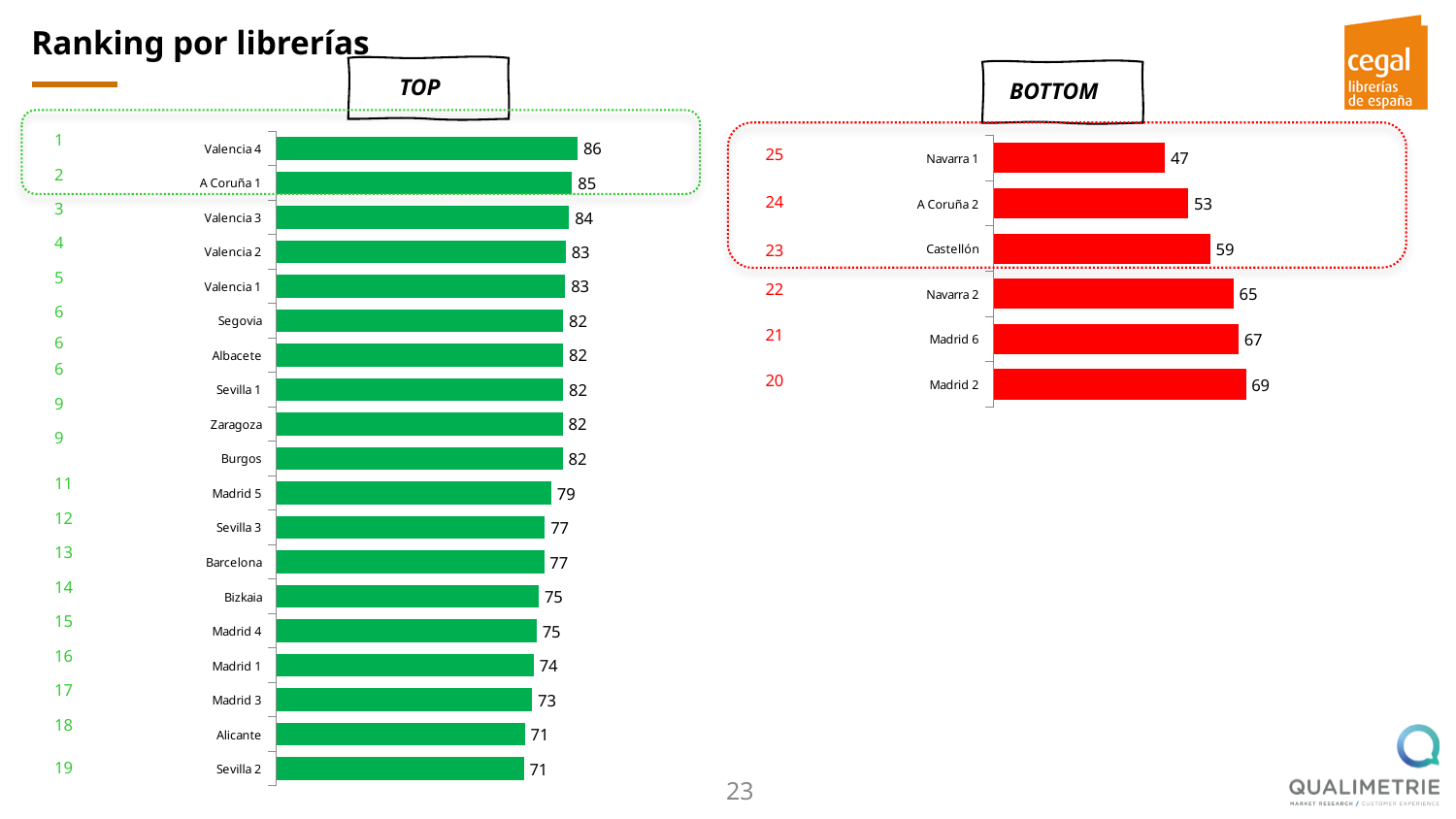
In the TOP chart, which category has the highest value? Valencia 4 In the TOP chart, what is the difference between the values for Valencia 4 and Sevilla 2? 15 In the BOTTOM chart, what is the difference between the values for Madrid 2 and Navarra 1? 22 In the TOP chart, what is the value for Valencia 4? 86 In the BOTTOM chart, what is the value for Castellón? 59 In the TOP chart, which is larger, the value for Bizkaia or the value for Madrid 1? Bizkaia How many bars are plotted in the TOP chart? 19 What kind of chart is the TOP chart? Bar chart In the BOTTOM chart, which category has the lowest value? Navarra 1 How many bars are plotted in the BOTTOM chart? 6 In the BOTTOM chart, which category has the highest value? Madrid 2 In the TOP chart, what is the value for Madrid 5? 79